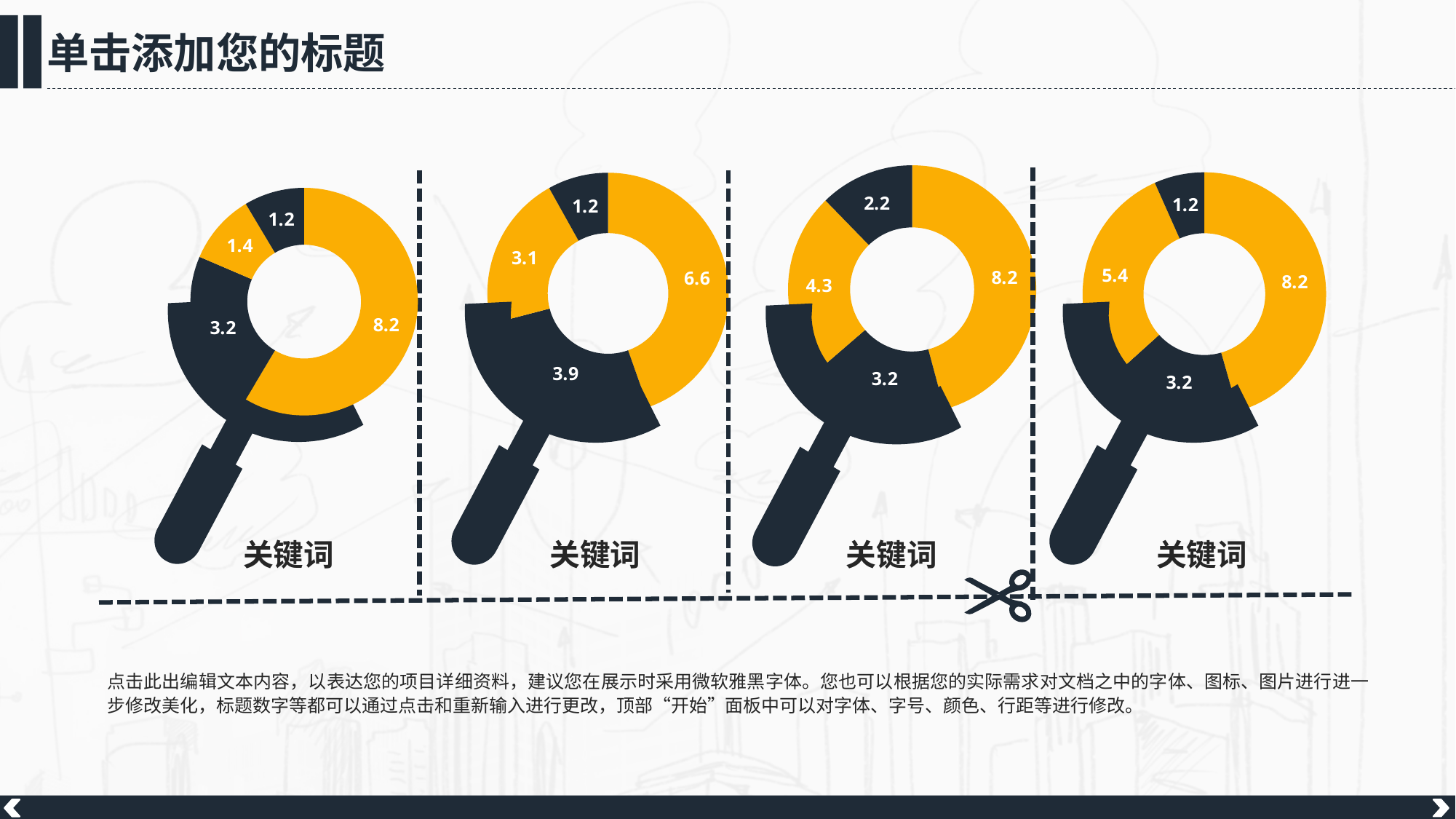
In the third chart from the left, what is the value of the smallest slice? 2.2 Which is larger: the largest slice in the second chart from the left (6.6) or the largest slice in the rightmost chart (8.2)? The rightmost chart's largest slice (8.2) In the third chart from the left, what is the total of all four slice values? 17.9 What two colours are used for the slices in the doughnut charts? Yellow-orange and dark navy In the leftmost chart, what is the value of the smallest slice? 1.2 In the second chart from the left, what is the value of the largest slice? 6.6 In the leftmost chart, what is the value of the largest slice? 8.2 In the leftmost chart, how many slices does the doughnut have? 4 How many charts are shown on the slide? 4 What kind of chart is the leftmost chart on the slide? Doughnut chart In the second chart from the left, what is the difference between the largest slice (6.6) and the smallest slice (1.2)? 5.4 In the rightmost chart, what is the total of all four slice values? 18.0